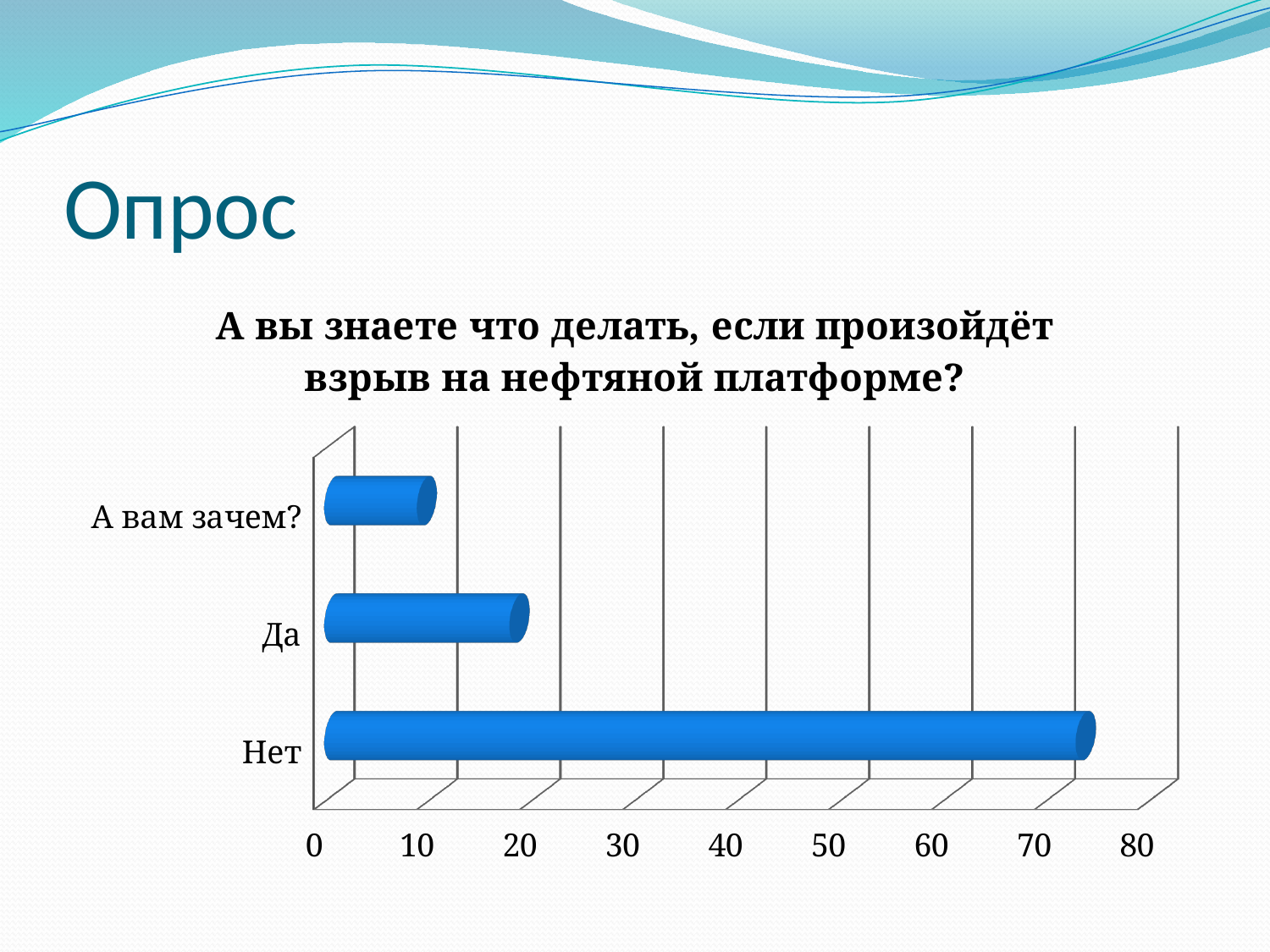
What kind of chart is shown on the slide? bar chart What is the highest value shown on the horizontal axis? 80 Is the value for "Нет" greater or less than 60? greater How many categories are shown in the chart? 3 Which category has the lowest value? А вам зачем? Which is larger, the value for "Да" or the value for "А вам зачем?"? Да Is the value for "Нет" greater or less than 80? less Which is larger, the value for "Нет" or the value for "Да"? Нет Is the value for "Да" greater or less than 30? less Which category has the highest value? Нет What is the title of the chart? А вы знаете что делать, если произойдёт взрыв на нефтяной платформе?